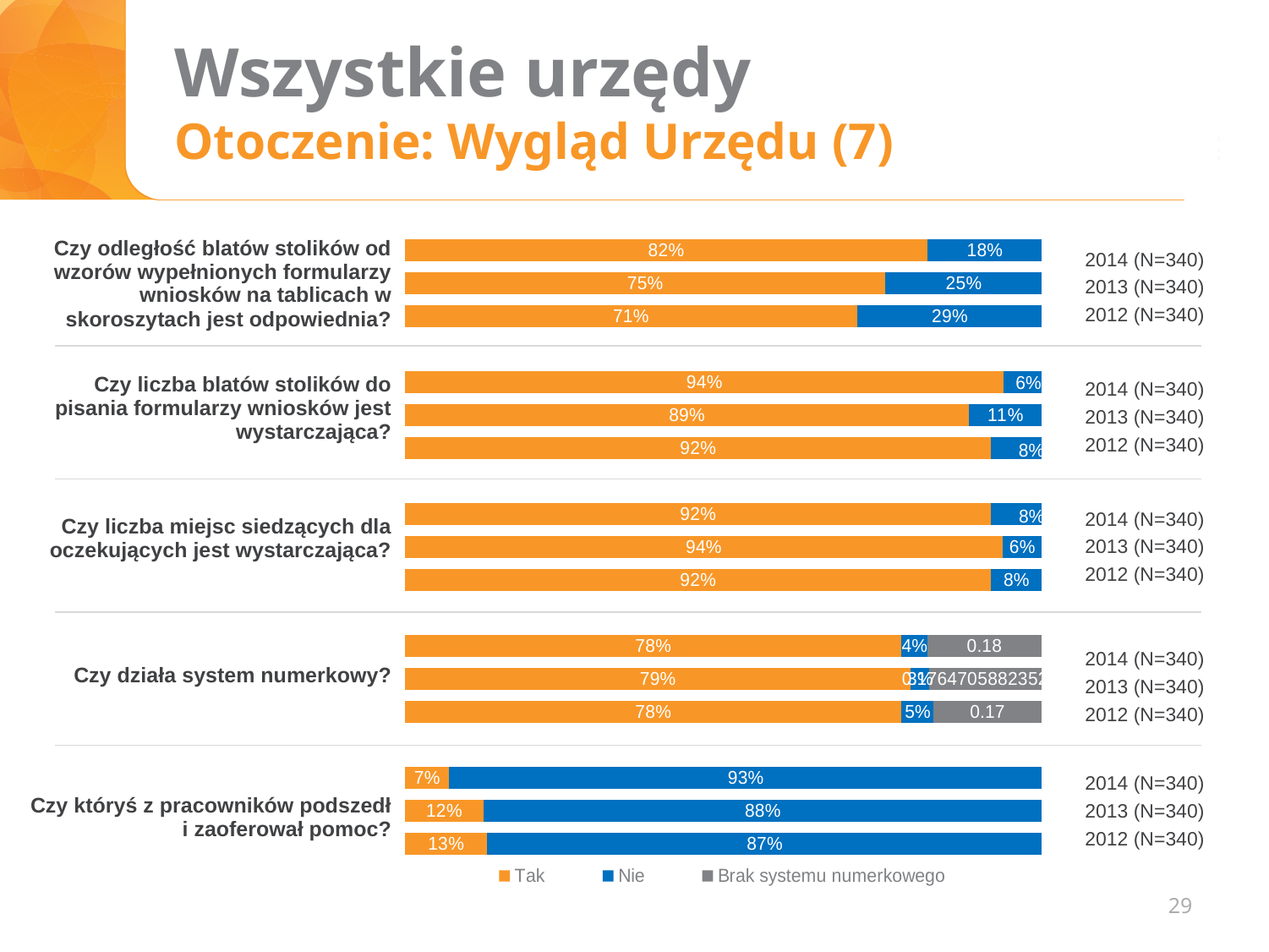
In the chart for "Czy liczba blatów stolików do pisania formularzy wniosków jest wystarczająca?", what is the "Nie" value for 2013 (N=340)? 11% In the chart for "Czy liczba miejsc siedzących dla oczekujących jest wystarczająca?", what is the difference between the "Tak" values for 2013 (N=340) and 2014 (N=340)? 2% In the chart for "Czy działa system numerkowy?", what is the "Nie" value for 2012 (N=340)? 5% In the chart for "Czy odległość blatów stolików od wzorów wypełnionych formularzy wniosków na tablicach w skoroszytach jest odpowiednia?", what is the "Tak" value for 2014 (N=340)? 82% How many series does the legend at the bottom of the slide list? 3 In the chart for "Czy działa system numerkowy?", what is the "Tak" value for 2013 (N=340)? 79% In the chart for "Czy liczba blatów stolików do pisania formularzy wniosków jest wystarczająca?", which year has the lowest "Tak" value? 2013 (N=340) In the chart for "Czy któryś z pracowników podszedł i zaoferował pomoc?", what is the "Nie" value for 2014 (N=340)? 93% In the chart for "Czy odległość blatów stolików od wzorów wypełnionych formularzy wniosków na tablicach w skoroszytach jest odpowiednia?", what is the "Nie" value for 2012 (N=340)? 29% In the chart for "Czy liczba miejsc siedzących dla oczekujących jest wystarczająca?", what is the "Tak" value for 2013 (N=340)? 94% In the chart for "Czy odległość blatów stolików od wzorów wypełnionych formularzy wniosków na tablicach w skoroszytach jest odpowiednia?", which year has the highest "Tak" value? 2014 (N=340) In the chart for "Czy któryś z pracowników podszedł i zaoferował pomoc?", is the "Tak" value for 2012 (N=340) larger or smaller than the "Tak" value for 2014 (N=340)? larger